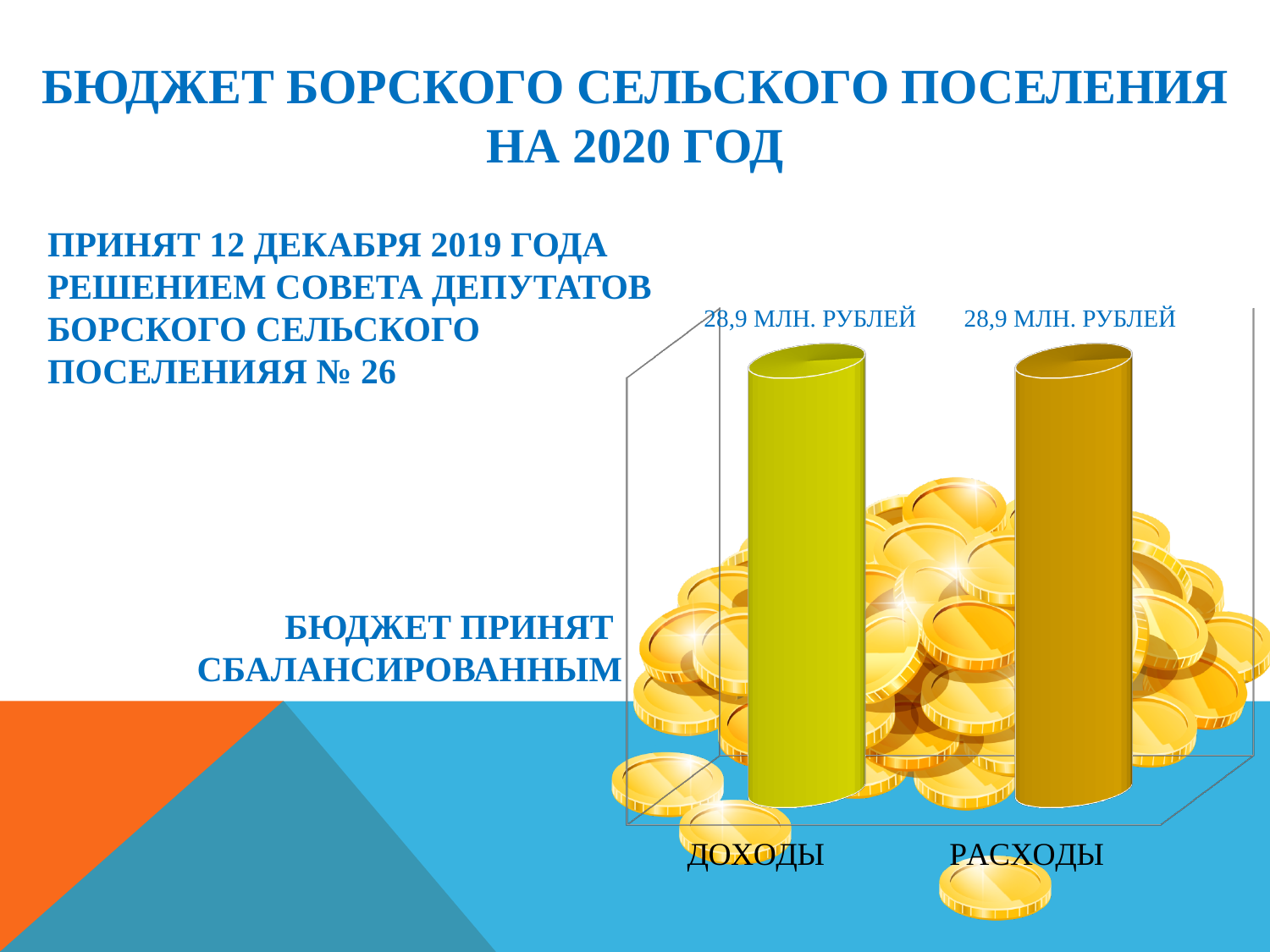
How many categories are plotted in the chart? 2 What is the value shown for РАСХОДЫ? 28,9 МЛН. РУБЛЕЙ What colour is the bar for ДОХОДЫ? yellow-green What is the difference between the values for ДОХОДЫ and РАСХОДЫ? 0 What are the labels of the two categories on the chart's x axis? ДОХОДЫ and РАСХОДЫ What kind of chart is shown on the slide? bar chart Is the value for ДОХОДЫ larger than, smaller than, or equal to the value for РАСХОДЫ? equal What is the value shown for ДОХОДЫ? 28,9 МЛН. РУБЛЕЙ